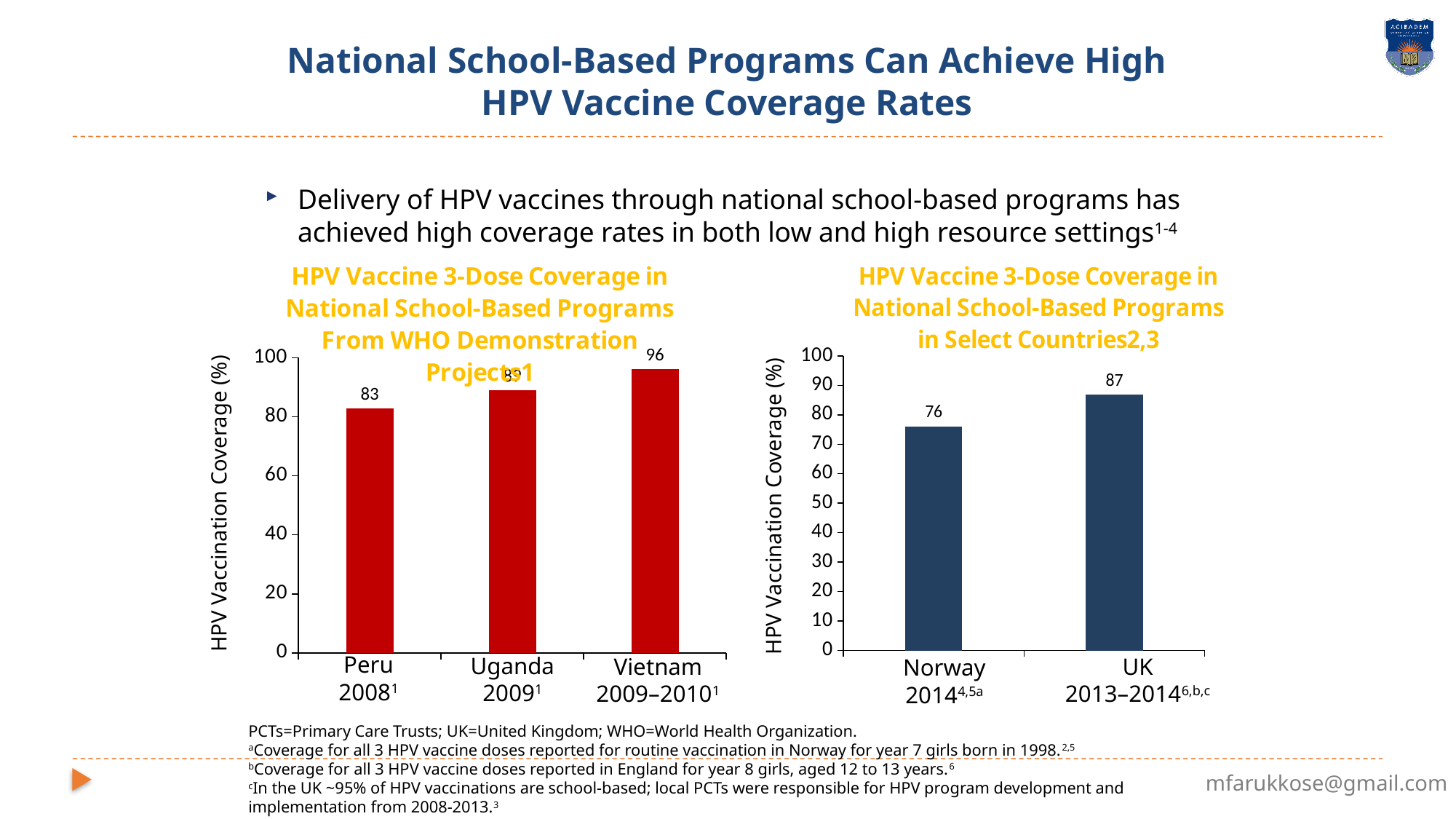
In the left chart (WHO Demonstration Projects), which country has the highest coverage? Vietnam In the left chart (WHO Demonstration Projects), is the value for Uganda greater or less than 80? greater In the left chart (WHO Demonstration Projects), what is the HPV vaccination coverage for Vietnam 2009–2010? 96 In the right chart (Select Countries), which country has the higher coverage, Norway or the UK? UK In the left chart (WHO Demonstration Projects), which country has the lowest coverage? Peru In the right chart (Select Countries), what is the HPV vaccination coverage for Norway 2014? 76 How many countries are shown in the left chart (WHO Demonstration Projects)? 3 In the right chart (Select Countries), what is the difference in coverage between the UK and Norway? 11 In the left chart (WHO Demonstration Projects), what is the difference in coverage between Vietnam and Peru? 13 In the left chart (WHO Demonstration Projects), what is the HPV vaccination coverage for Peru 2008? 83 What type of chart is the right chart (Select Countries)? Bar chart In the right chart (Select Countries), what is the HPV vaccination coverage for the UK 2013–2014? 87